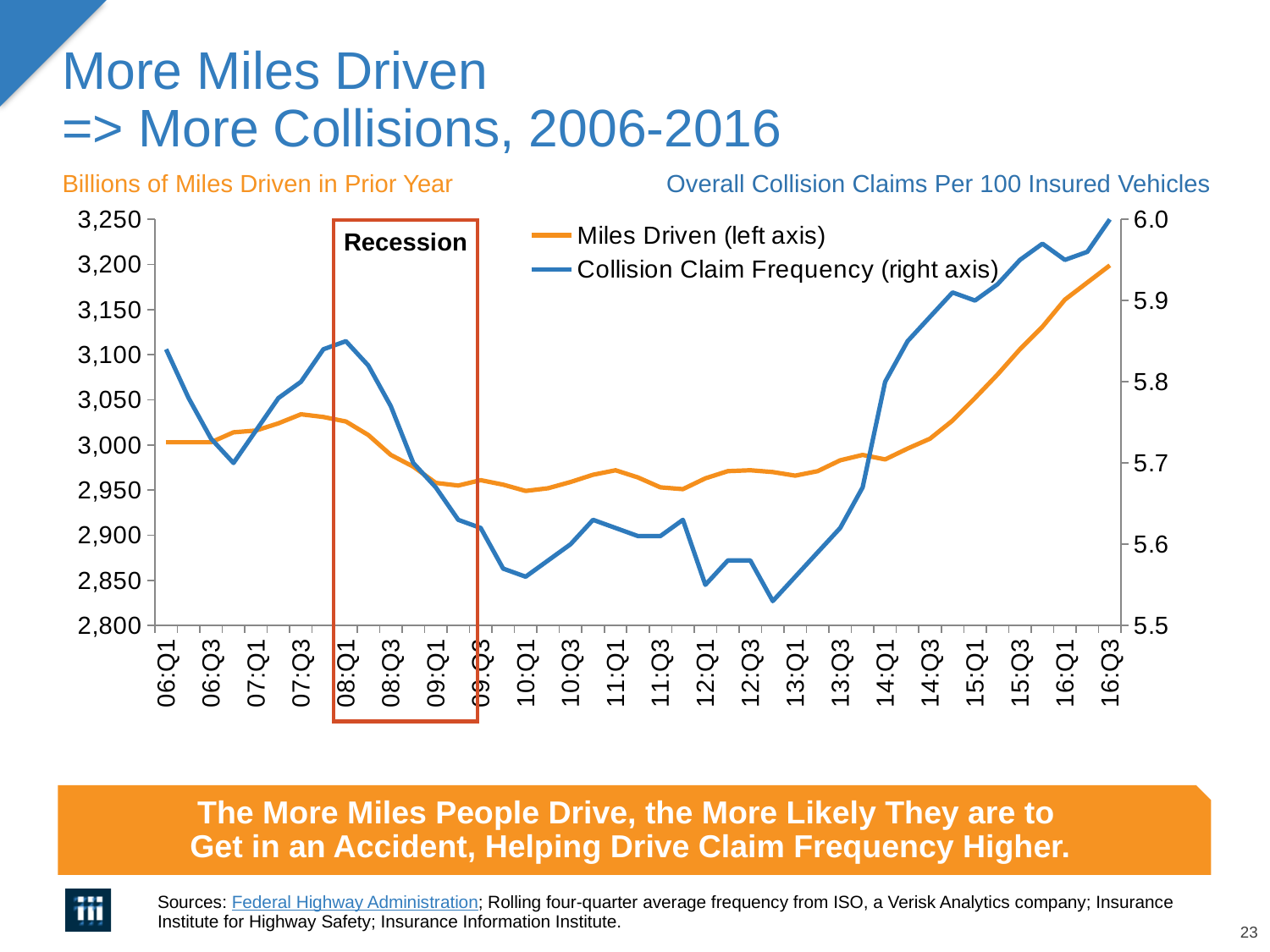
Is the value for Collision Claim Frequency at 13:Q1 greater or less than 5.6? less How many series does the legend list? 2 Is the value for Collision Claim Frequency at 16:Q3 greater or less than 5.9? greater Is the value for Miles Driven at 16:Q3 greater or less than 3,150? greater Does Collision Claim Frequency rise or fall between 08:Q1 and 10:Q1? fall At which quarter is Miles Driven highest? 16:Q3 Which series is plotted against the right axis according to the legend? Collision Claim Frequency Which is larger, Miles Driven at 16:Q3 or Miles Driven at 06:Q1? 16:Q3 What kind of chart is shown on the slide? Line chart What is the title of the left axis? Billions of Miles Driven in Prior Year